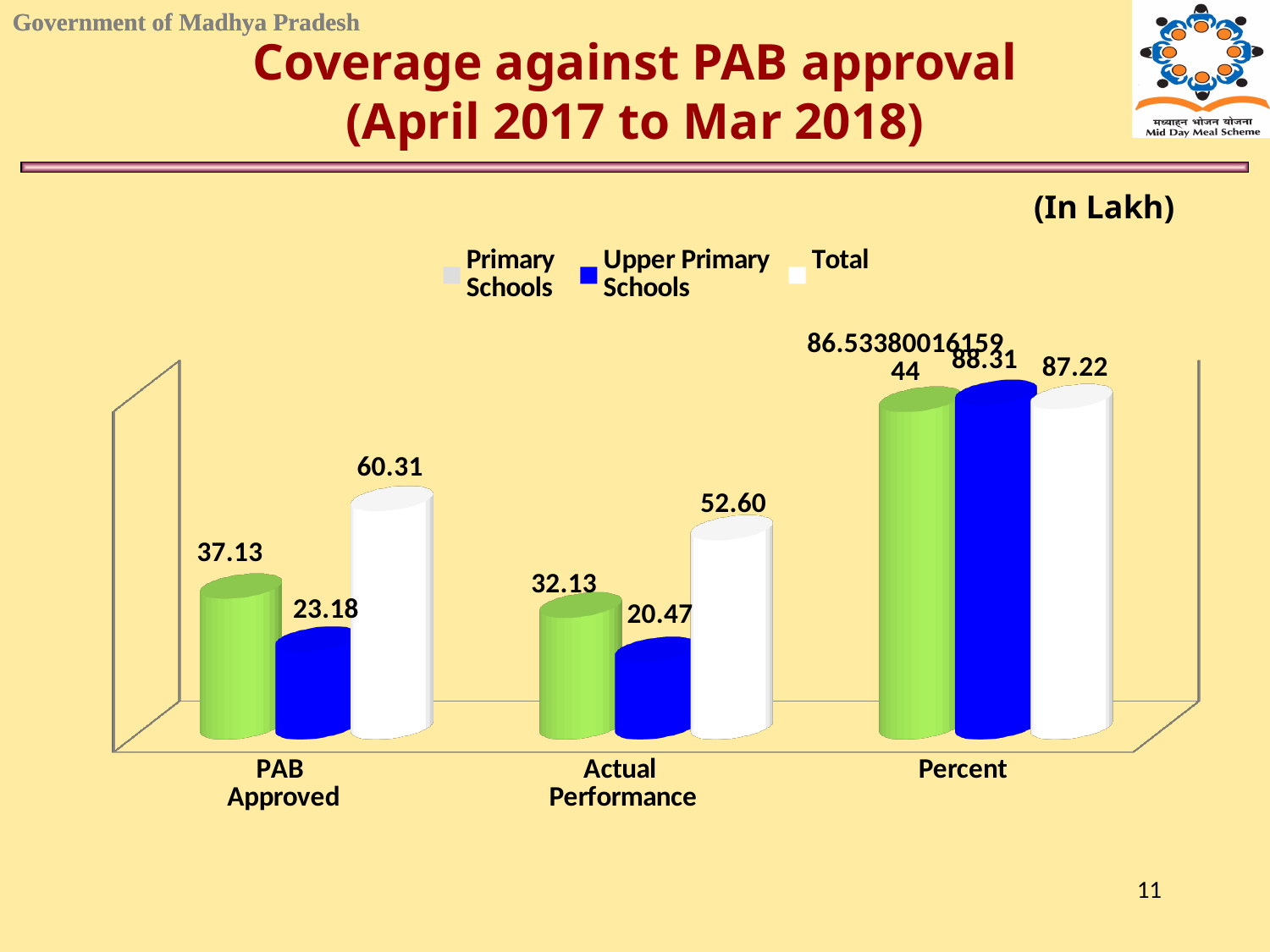
What is the value for Total in the Percent category? 87.22 How many series does the legend list? 3 What is the difference between the Total value for PAB Approved and the Total value for Actual Performance? 7.71 How many categories are shown on the x axis of the chart? 3 What kind of chart is shown on the slide? Bar chart Which series has the lowest value in the Actual Performance category? Upper Primary Schools What is the difference between the Primary Schools value for PAB Approved and the Primary Schools value for Actual Performance? 5.00 What is the value for Total in the PAB Approved category? 60.31 What is the value for Upper Primary Schools in the Actual Performance category? 20.47 Which is larger for Upper Primary Schools: the PAB Approved value or the Actual Performance value? PAB Approved What is the value for Primary Schools in the PAB Approved category? 37.13 Which series has the highest value in the PAB Approved category? Total